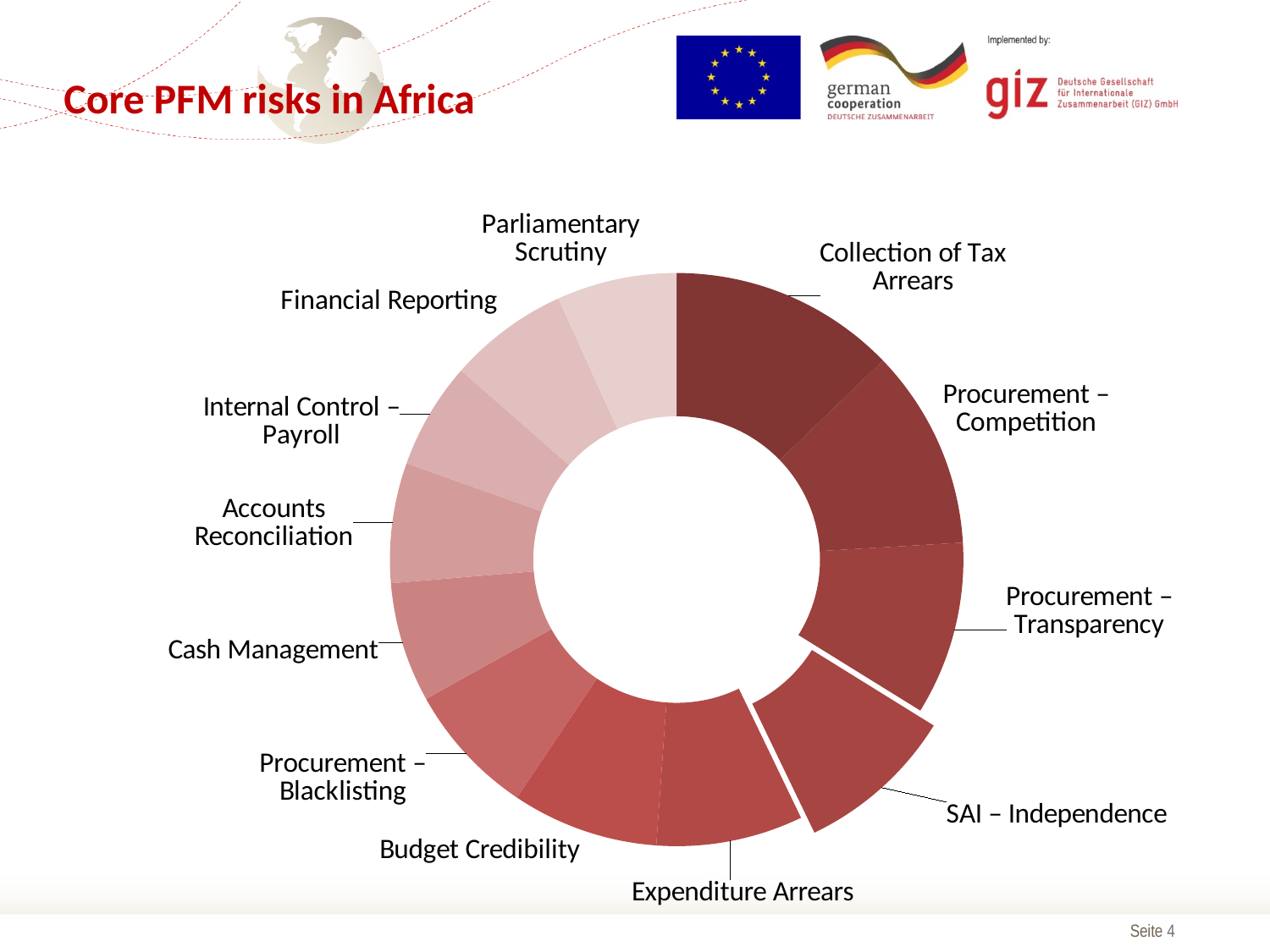
What is the title of the slide containing the chart? Core PFM risks in Africa Which slice is larger: Accounts Reconciliation or Collection of Tax Arrears? Collection of Tax Arrears How many categories (slices) does the chart show? 12 Which slice is larger: Procurement – Competition or Financial Reporting? Procurement – Competition What kind of chart is shown on the slide? Doughnut (pie) chart Which slice is larger: Procurement – Transparency or Internal Control – Payroll? Procurement – Transparency Does the chart display numeric data labels on its slices? No Which slice is pulled out (exploded) from the rest of the doughnut? SAI – Independence